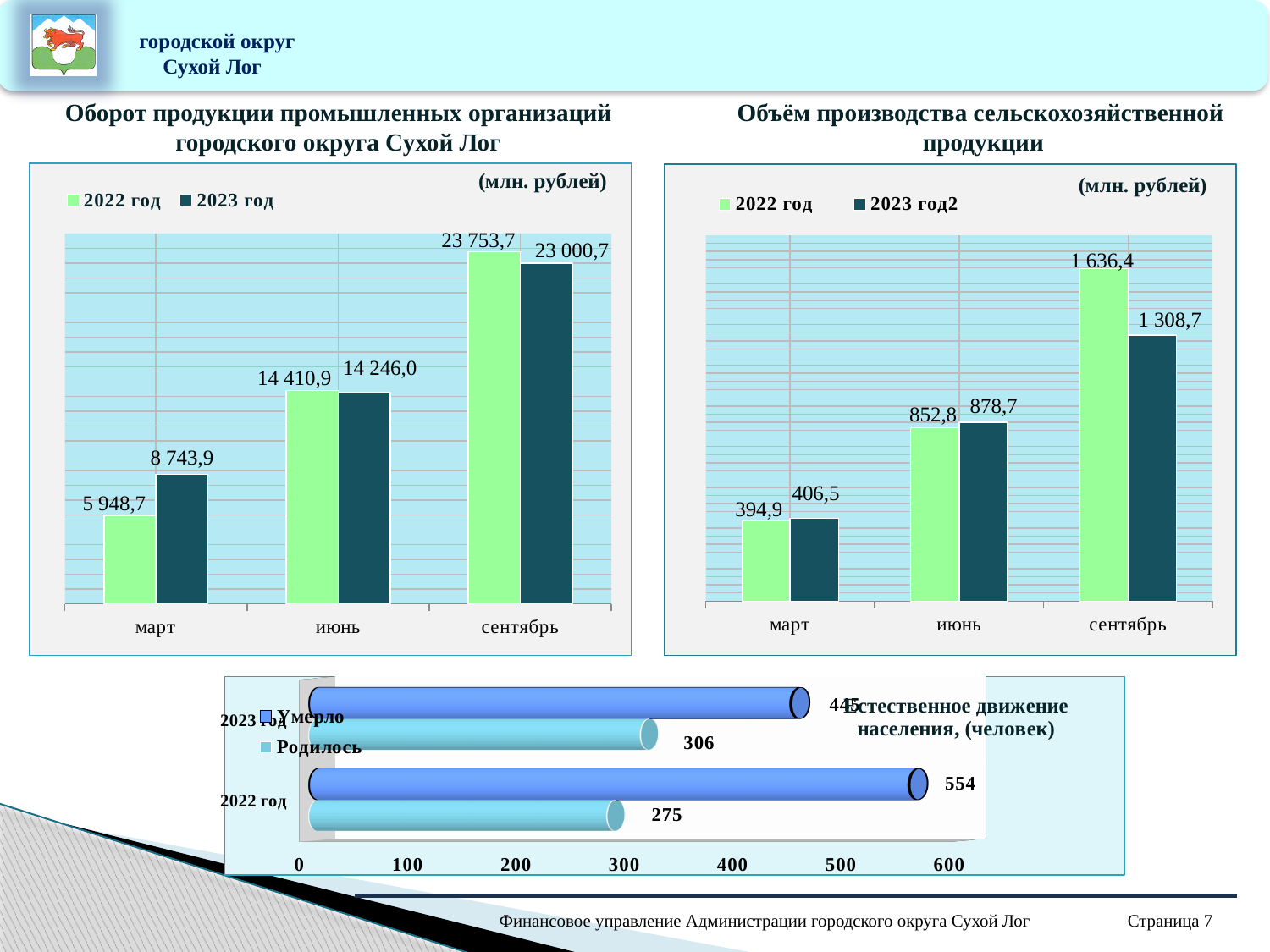
On the chart 'Оборот продукции промышленных организаций городского округа Сухой Лог', which month has the lowest value in the 2022 год series? март On the chart 'Естественное движение населения, (человек)', what is the Родилось value for 2022 год? 275 On the chart 'Оборот продукции промышленных организаций городского округа Сухой Лог', how many series does the legend list? 2 On the chart 'Оборот продукции промышленных организаций городского округа Сухой Лог', what is the value for март in the 2023 год series? 8 743,9 On the chart 'Естественное движение населения, (человек)', what is the Умерло value for 2022 год? 554 On the chart 'Оборот продукции промышленных организаций городского округа Сухой Лог', what is the difference between the 2022 год and 2023 год values for март? 2 795,2 On the chart 'Объём производства сельскохозяйственной продукции', what is the value for июнь in the 2023 год2 series? 878,7 What kind of chart is 'Естественное движение населения, (человек)'? bar chart On the chart 'Объём производства сельскохозяйственной продукции', which is larger for сентябрь: the 2022 год value or the 2023 год2 value? 2022 год On the chart 'Объём производства сельскохозяйственной продукции', how many categories are shown on the x axis? 3 On the chart 'Объём производства сельскохозяйственной продукции', do the 2022 год values rise or fall from март to сентябрь? rise On the chart 'Оборот продукции промышленных организаций городского округа Сухой Лог', what is the value for сентябрь in the 2022 год series? 23 753,7